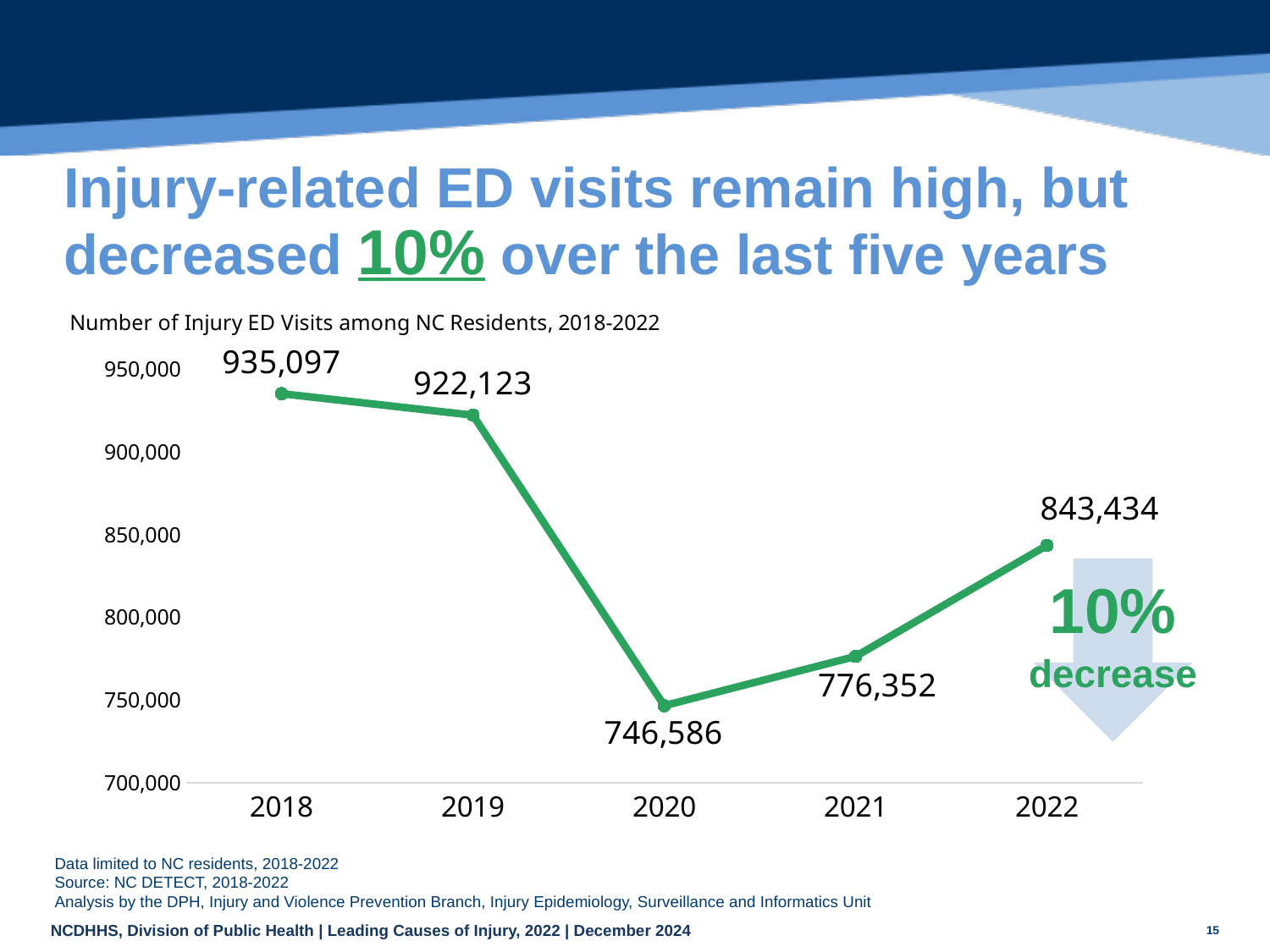
What is the number of injury ED visits in 2020? 746,586 Which year has the lowest number of injury ED visits? 2020 Is the value for 2021 greater or less than 800,000? less What is the title of the chart? Number of Injury ED Visits among NC Residents, 2018-2022 What is the number of injury ED visits in 2022? 843,434 What is the difference in injury ED visits between 2018 and 2022? 91,663 How many years are plotted on the chart? 5 Which year had more injury ED visits, 2021 or 2022? 2022 What kind of chart is shown on the slide? line chart Which year has the highest number of injury ED visits? 2018 What is the difference in injury ED visits between 2019 and 2020? 175,537 What is the number of injury ED visits in 2018? 935,097